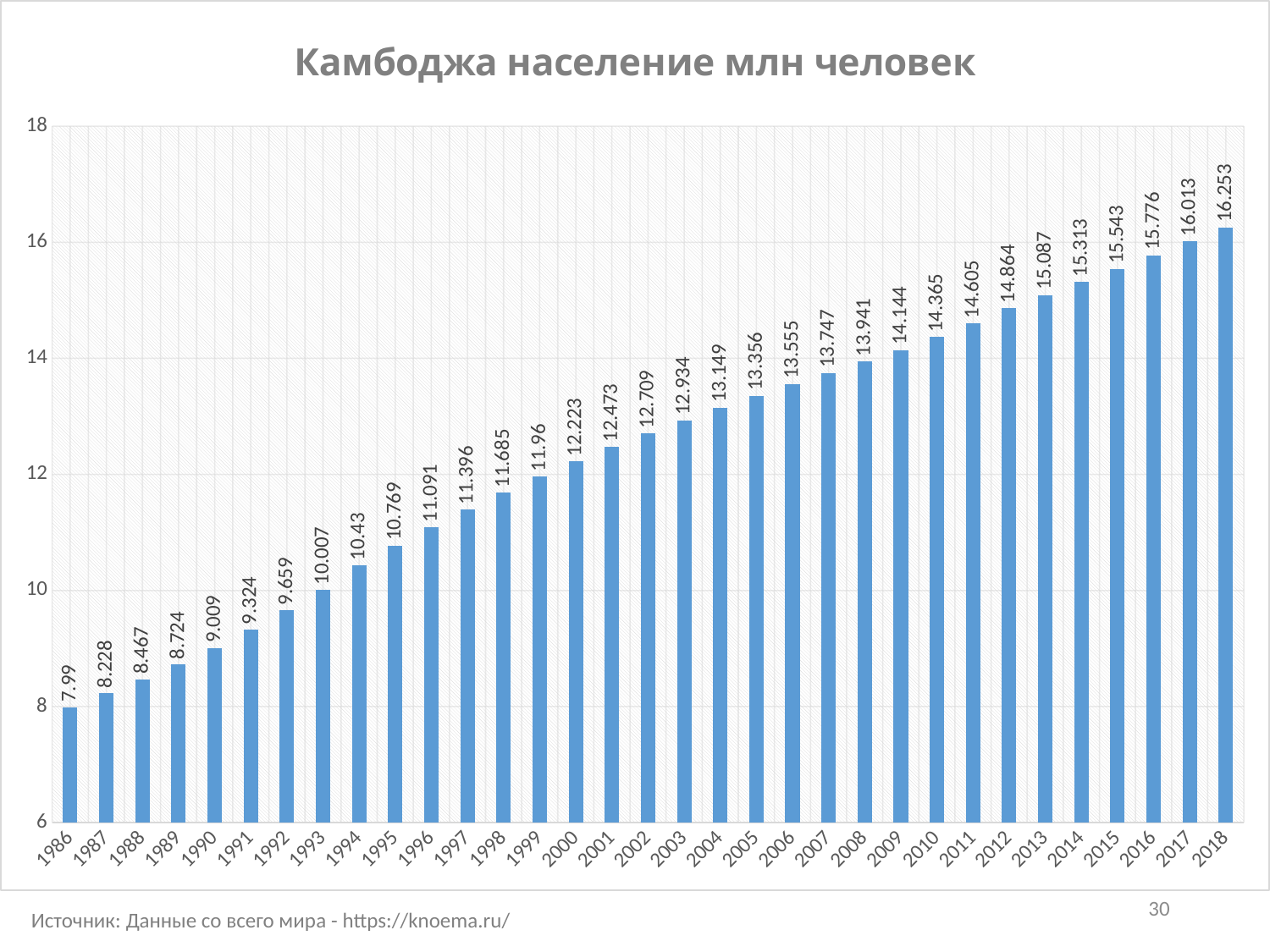
What is the difference between the population values for 2000 and 1990? 3.214 What is the population value shown for 2000? 12.223 What is the population value shown for 1993? 10.007 How many years are shown on the x axis? 33 What kind of chart is this? Bar chart Which year has the highest population value? 2018 Which year has the lowest population value? 1986 Which year has a larger population value, 2005 or 1995? 2005 What is the population value shown for 2018? 16.253 What is the difference between the population values for 2018 and 1986? 8.263 What is the population value shown for 1986? 7.99 Do the population values rise or fall from 1986 to 2018? Rise